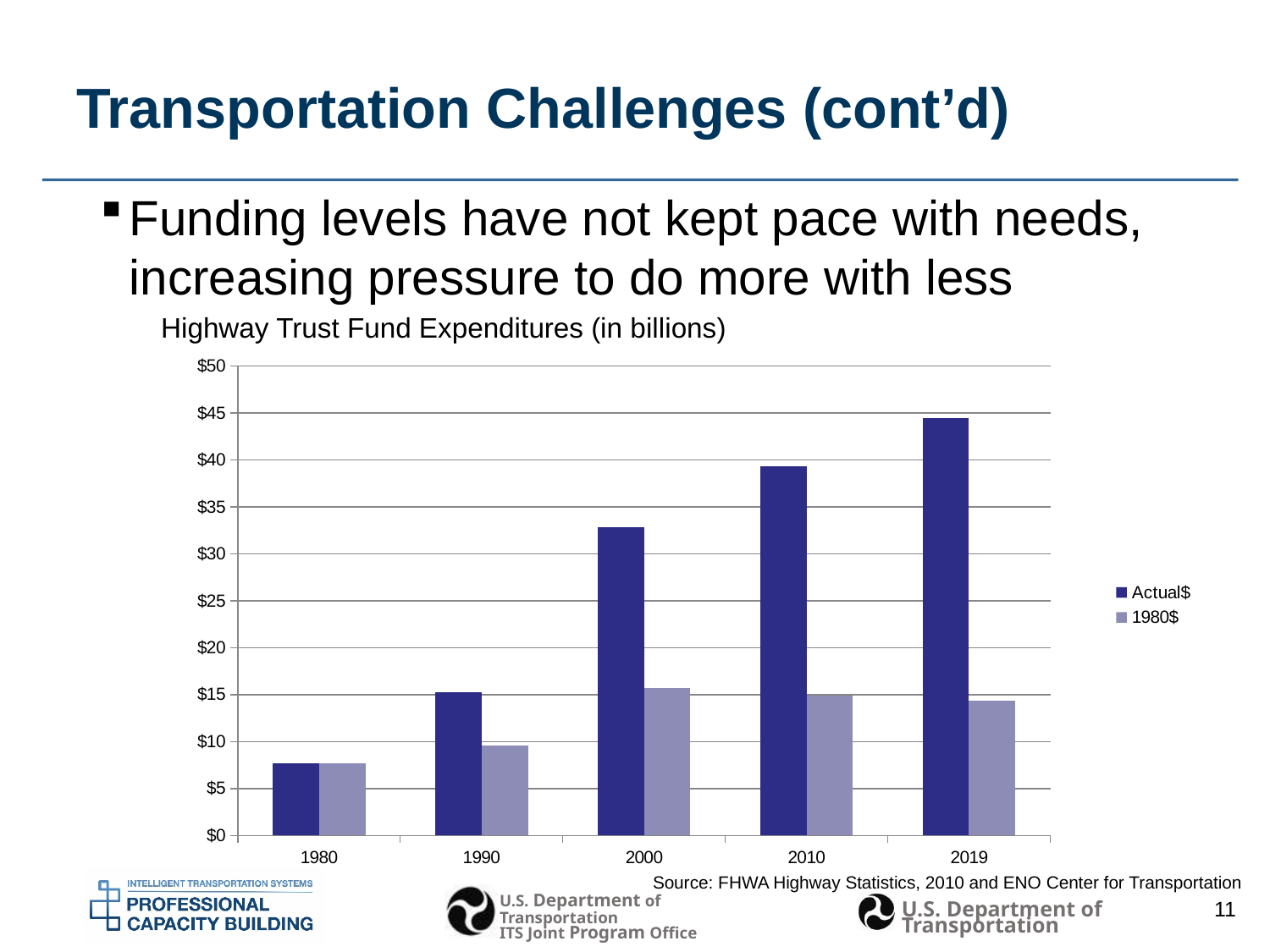
How many series does the chart's legend list? 2 In 2019, which is larger: the Actual$ value or the 1980$ value? Actual$ Which year has the highest Actual$ value? 2019 Which year has the lowest 1980$ value? 1980 What are the two series named in the legend? Actual$ and 1980$ What type of chart is shown on the slide? Bar chart Is the Actual$ value for 2019 greater or less than $40? greater Which year has the lowest Actual$ value? 1980 What is the title of the chart? Highway Trust Fund Expenditures (in billions) Do the Actual$ values rise or fall from 1980 to 2019? Rise Is the Actual$ value for 1990 greater or less than $20? less How many years are shown on the x axis of the chart? 5